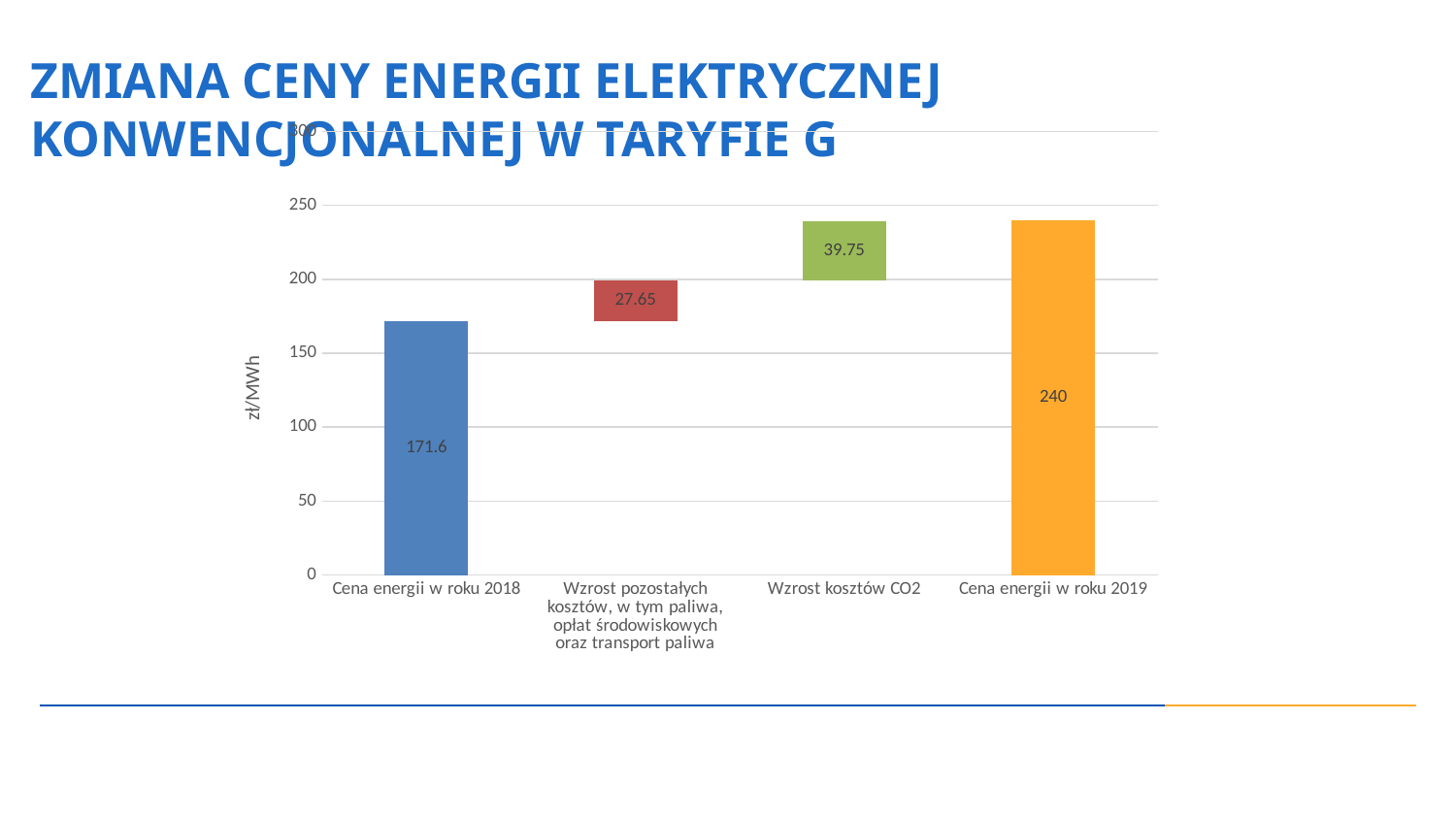
Which category has the highest labelled value? Cena energii w roku 2019 Which is larger, the value for "Wzrost kosztów CO2" or the value for "Wzrost pozostałych kosztów"? Wzrost kosztów CO2 Which category has the lowest labelled value? Wzrost pozostałych kosztów, w tym paliwa, opłat środowiskowych oraz transport paliwa Is the value for "Cena energii w roku 2018" greater or less than 200? less What is the difference between the "Wzrost kosztów CO2" value and the "Wzrost pozostałych kosztów" value? 12.1 What unit is shown on the vertical axis label? zł/MWh How many categories are shown on the x axis? 4 What is the value for "Cena energii w roku 2019"? 240 What is the value labelled on the "Wzrost kosztów CO2" bar? 39.75 What is the difference between the value for "Cena energii w roku 2019" and the value for "Cena energii w roku 2018"? 68.4 What is the value labelled on the "Wzrost pozostałych kosztów, w tym paliwa, opłat środowiskowych oraz transport paliwa" bar? 27.65 What is the value for "Cena energii w roku 2018"? 171.6